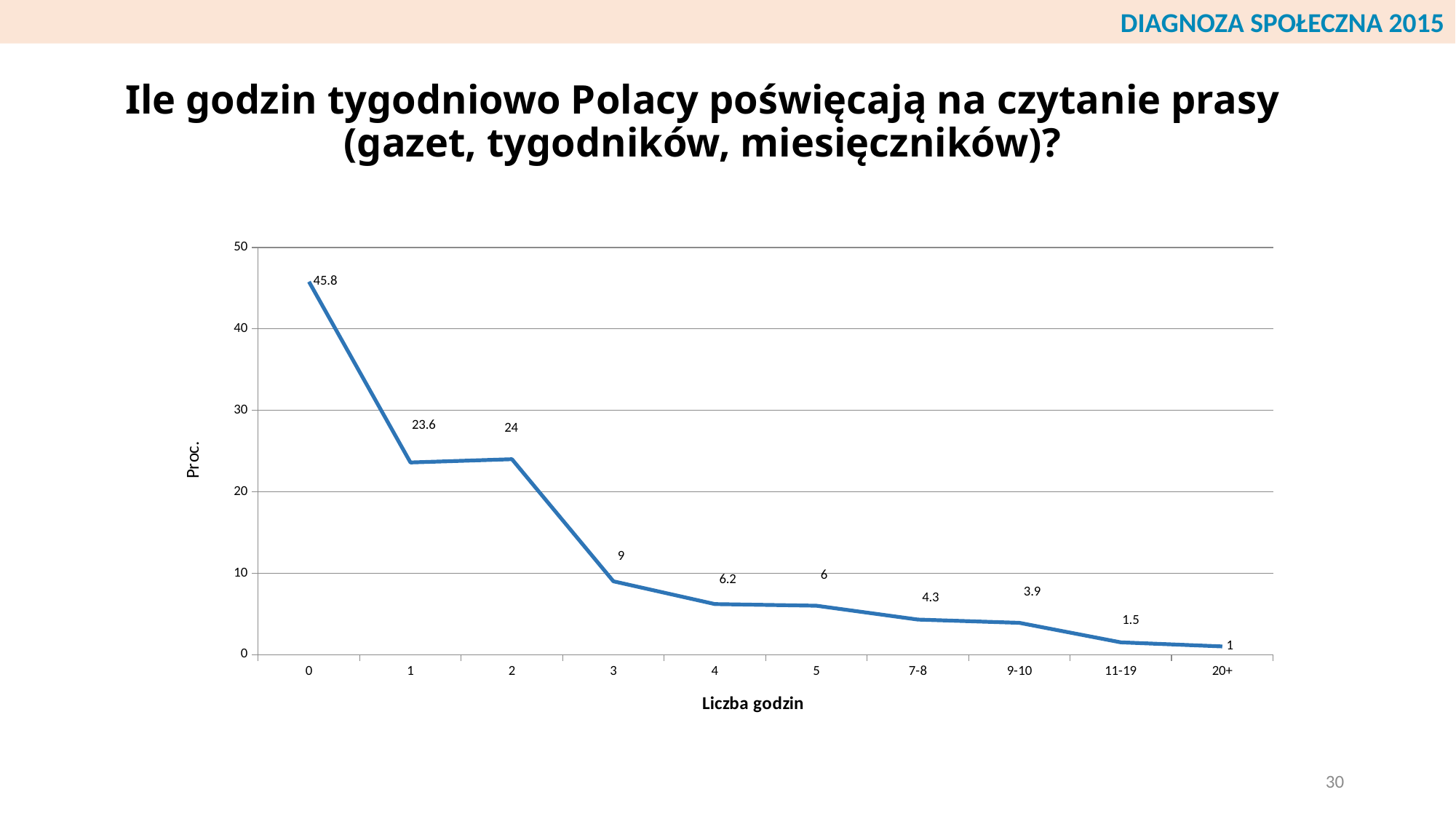
What is the value for the '3' hours category? 9 How many categories are shown on the x axis? 10 Which is larger, the value for '4' hours or the value for '7-8' hours? 4 Which category on the x axis has the highest value? 0 What is the label of the x axis? Liczba godzin What is the difference between the values for '1' hour and '2' hours? 0.4 What is the difference between the values for '0' hours and '1' hour? 22.2 Which category on the x axis has the lowest value? 20+ What percentage of Poles spend 0 hours per week reading the press? 45.8 What kind of chart is shown on the slide? line chart What is the value for the '11-19' hours category? 1.5 Do the values generally rise or fall from left to right along the x axis? fall